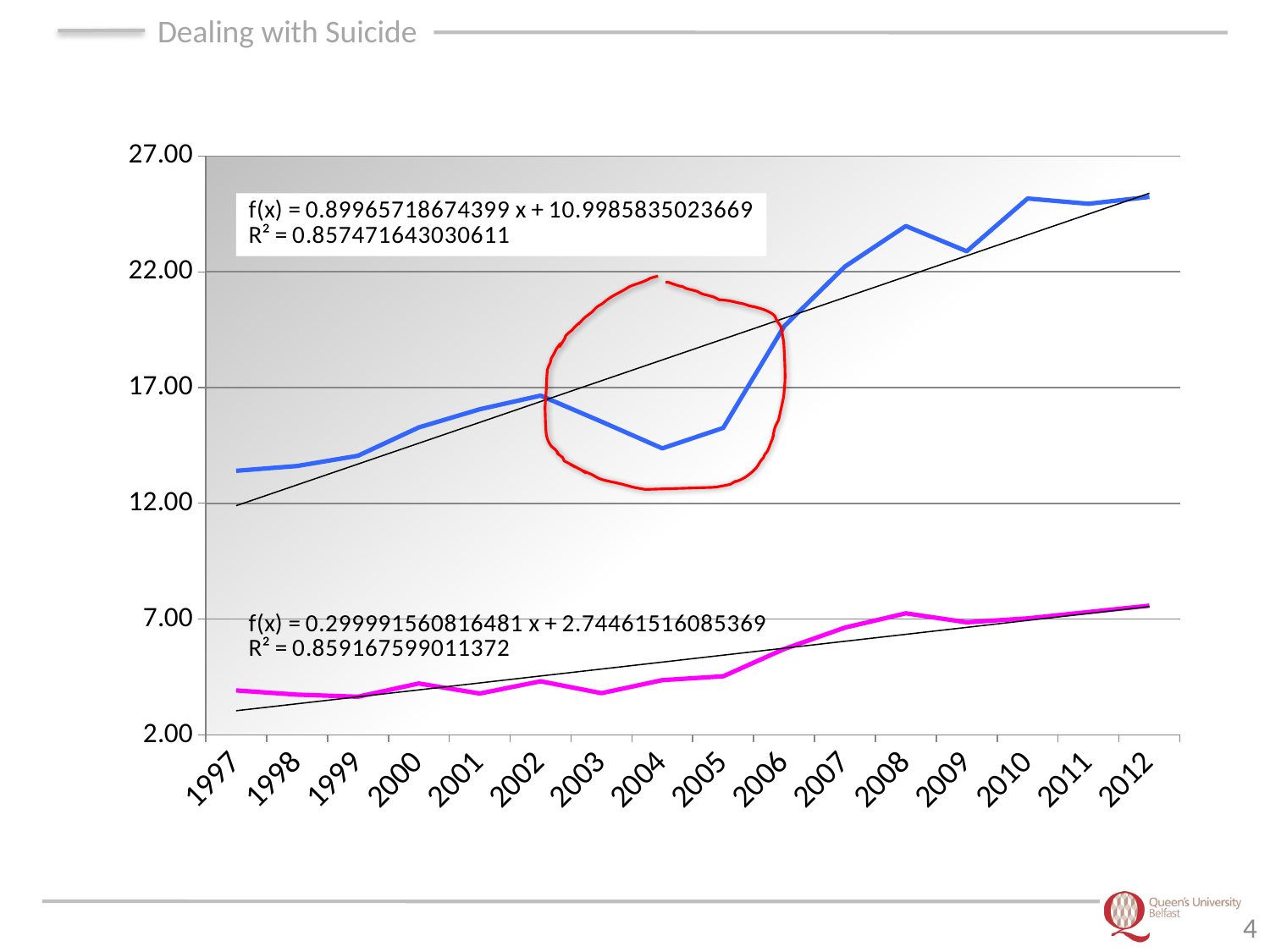
Does the magenta line generally rise or fall from 1997 to 2012? rise What is the slope in the trendline equation shown for the lower (magenta) series? 0.299991560816481 How many years are shown along the x axis of the chart? 16 Is the value of the blue line in 2004 greater or less than 17.00? less What kind of chart is shown on the slide? line chart Is the value of the magenta line in 2003 greater or less than 7.00? less Which is larger for the magenta line: the value in 1997 or the value in 2012? 2012 What is the R² value shown for the trendline of the upper (blue) series? 0.857471643030611 Is the value of the blue line in 2010 greater or less than 22.00? greater Which is larger for the blue line: the value in 2002 or the value in 2004? 2002 Does the blue line generally rise or fall from 1997 to 2012? rise